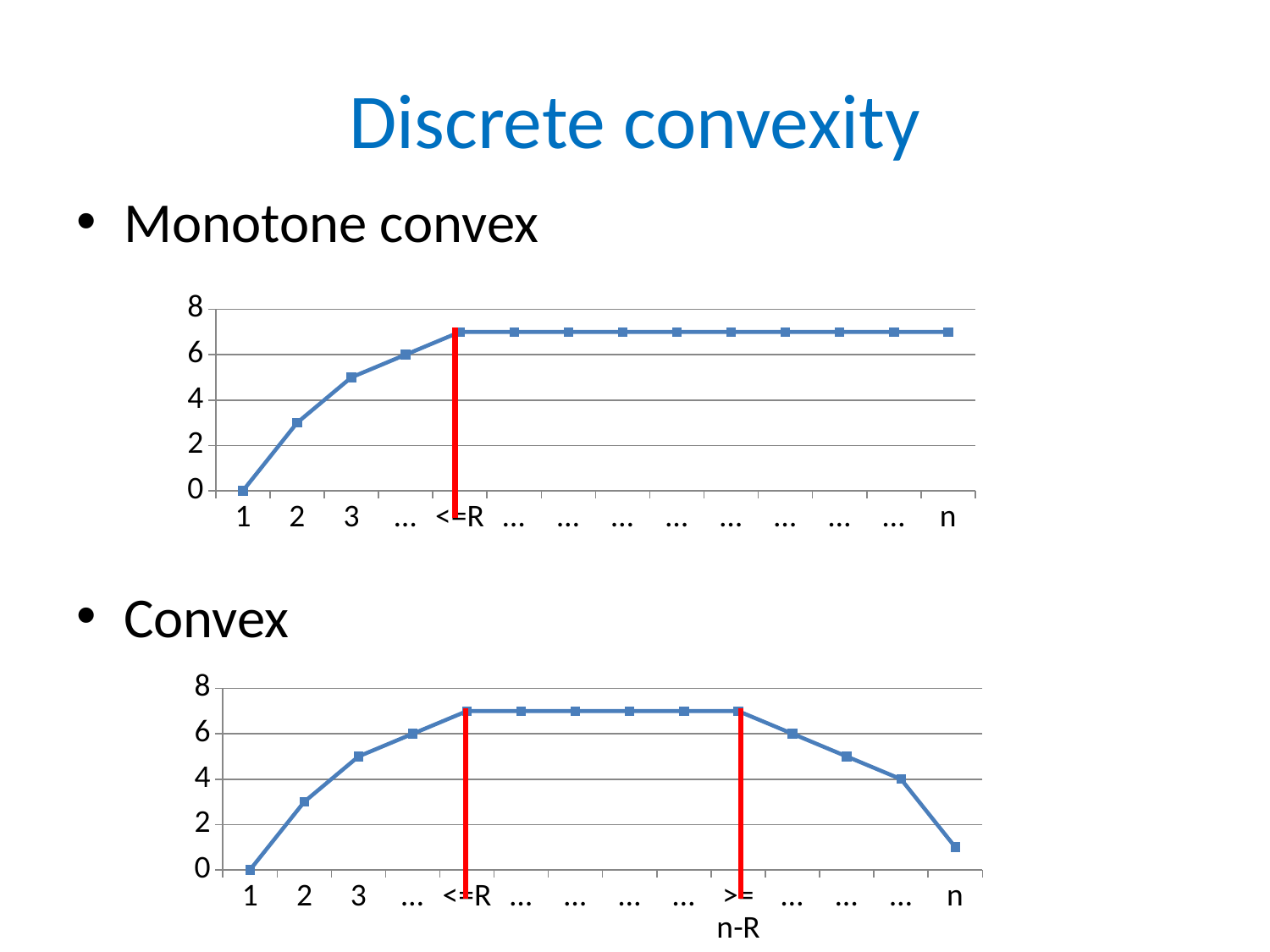
In the top chart (Monotone convex), do the values rise, fall, or stay flat from category '<=R' to category n? stay flat In the top chart (Monotone convex), how many categories are on the x axis? 14 In the bottom chart (Convex), do the values rise or fall from category '>= n-R' to category n? fall In the bottom chart (Convex), which is larger, the value at category 3 or the value at category n? category 3 In the top chart (Monotone convex), which category has the lowest value? 1 In the top chart (Monotone convex), is the value at category n greater or less than 6? greater What is the title of the slide containing the two charts? Discrete convexity In the bottom chart (Convex), is the value at category n greater or less than 2? less In the top chart (Monotone convex), is the value at category 2 greater or less than 2? greater In the bottom chart (Convex), what is the value at category 1? 0 In the top chart (Monotone convex), what is the value at category 1? 0 What kind of chart is the top chart under 'Monotone convex'? line chart